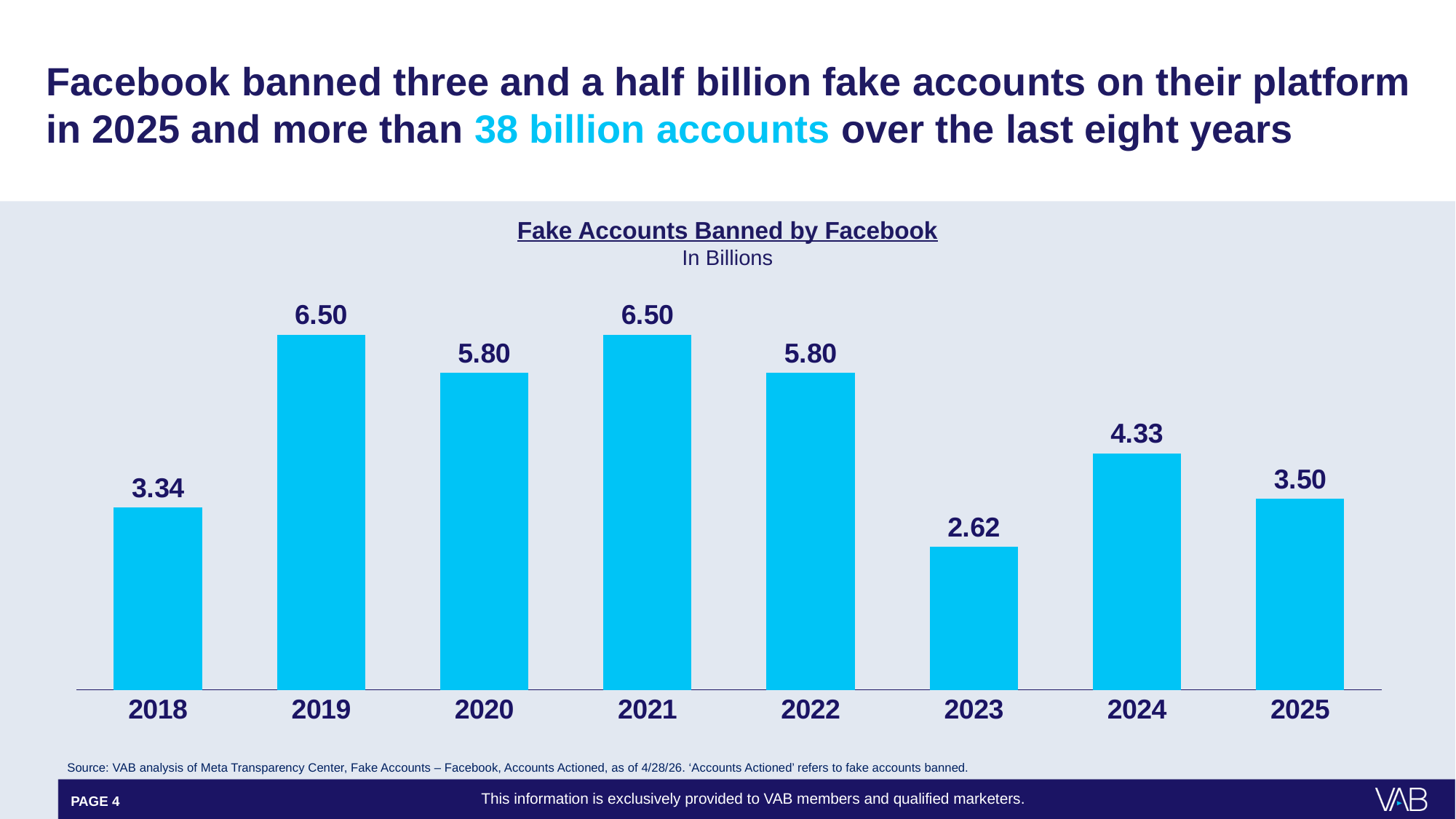
What is the difference between the values for 2024 and 2023? 1.71 What is the value for 2025? 3.50 Which is larger, the value for 2018 or the value for 2025? 2025 What is the value for 2018? 3.34 What is the value for 2024? 4.33 What kind of chart is shown on the slide? bar chart How many years are shown on the x axis of the chart? 8 Which year has the lowest value? 2023 What is the title of the chart? Fake Accounts Banned by Facebook What is the difference between the values for 2019 and 2020? 0.70 What is the highest value shown in the chart? 6.50 Do the values rise or fall from 2021 to 2023? fall